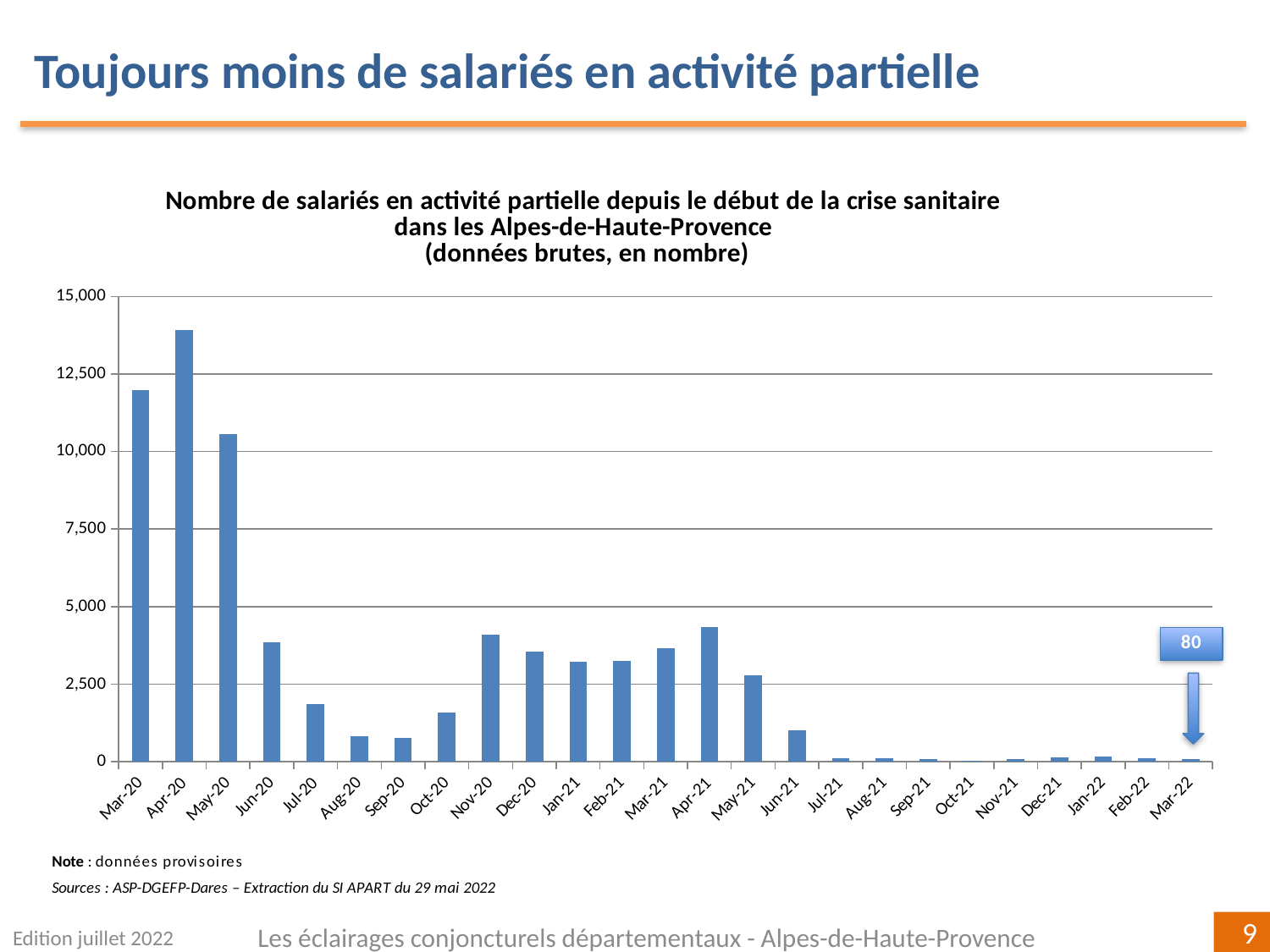
Which is larger, the value for Nov-20 or the value for Dec-20? Nov-20 Overall, do the values rise or fall from Mar-20 to Mar-22? fall What is the first line of the chart title? Nombre de salariés en activité partielle depuis le début de la crise sanitaire How many months are plotted on the x axis? 25 Which is larger, the value for Apr-20 or the value for May-20? Apr-20 What kind of chart is shown on the slide? bar chart Is the value for Jul-20 greater or less than 2,500? less Is the value for Jun-20 greater or less than 5,000? less What is the number of employees in partial activity in Mar-22, as shown by the data label? 80 Is the value for Apr-20 greater or less than 12,500? greater Which month has the highest number of employees in partial activity? Apr-20